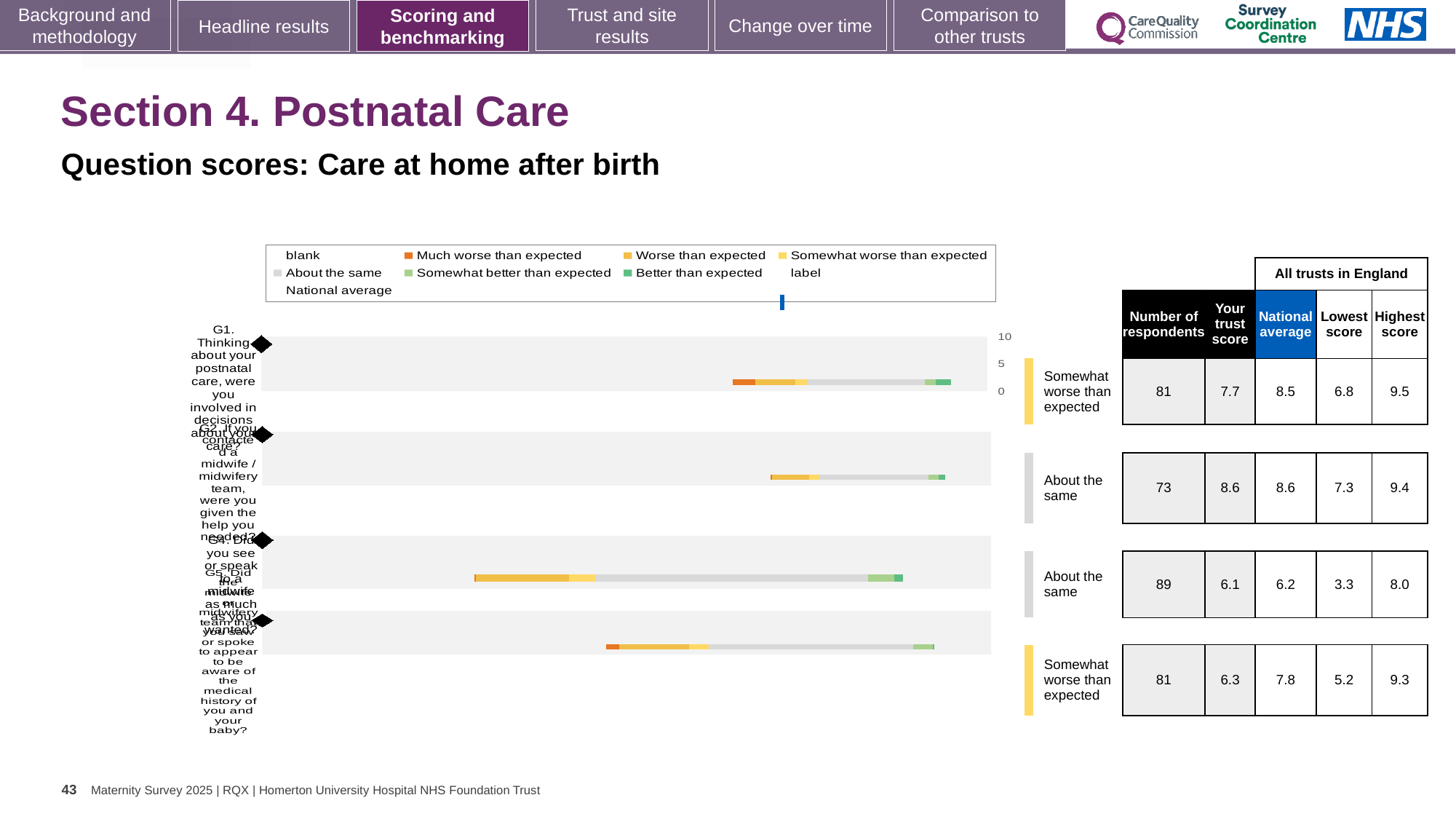
How many respondents are listed for question G1 (involved in decisions about your postnatal care)? 81 What is the lowest score across all trusts in England for question G5 (midwife aware of medical history)? 5.2 For question G1, which is larger: the trust score or the national average? National average For question G5, how much higher is the national average (7.8) than the trust score (6.3)? 1.5 What colour does the legend use for 'Much worse than expected'? Orange How many questions (bars) are plotted in the chart? 4 Which question has the highest 'Your trust score' in the table? G2 What is the national average for question G4 (see or speak to a midwife as much as you wanted)? 6.2 What benchmark category is shown for question G4? About the same What is the trust score for question G2 (given the help you needed when contacting a midwife)? 8.6 Which question has the lowest 'Your trust score' in the table? G4 What kind of chart is shown on the slide? Bar chart